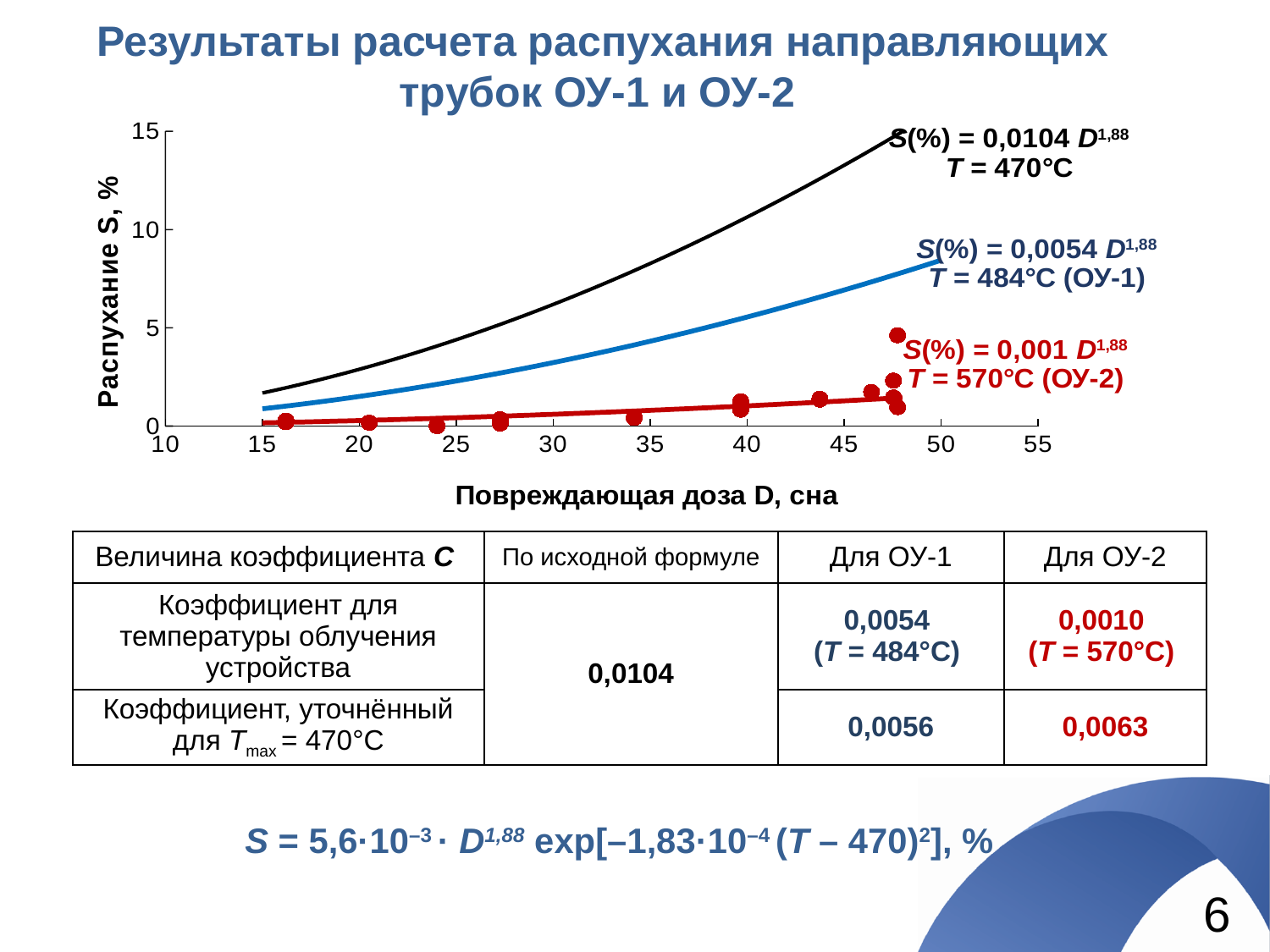
How many fitted curves are plotted on the chart? 3 What is the title of the x axis of the chart? Повреждающая доза D, сна Is the value of the blue curve (ОУ-1) at D = 30 greater or less than 5? less Is the value of the black curve (T = 470°C) at D = 30 greater or less than 5? greater At D = 40, which curve is higher: the black curve (T = 470°C) or the blue curve (ОУ-1)? the black curve (T = 470°C) Is the value of the black curve (T = 470°C) at D = 45 greater or less than 10? greater At D = 45, which curve is higher: the blue curve (ОУ-1) or the red curve (ОУ-2)? the blue curve (ОУ-1) Do the swelling values rise or fall as the damaging dose D increases along the x axis? rise What coefficient appears in the formula labelling the black curve, S(%) = C·D^1,88? 0,0104 What kind of chart is shown on the slide? line chart Which curve has the lowest swelling values across the plotted dose range? the red curve (ОУ-2, T = 570°C)